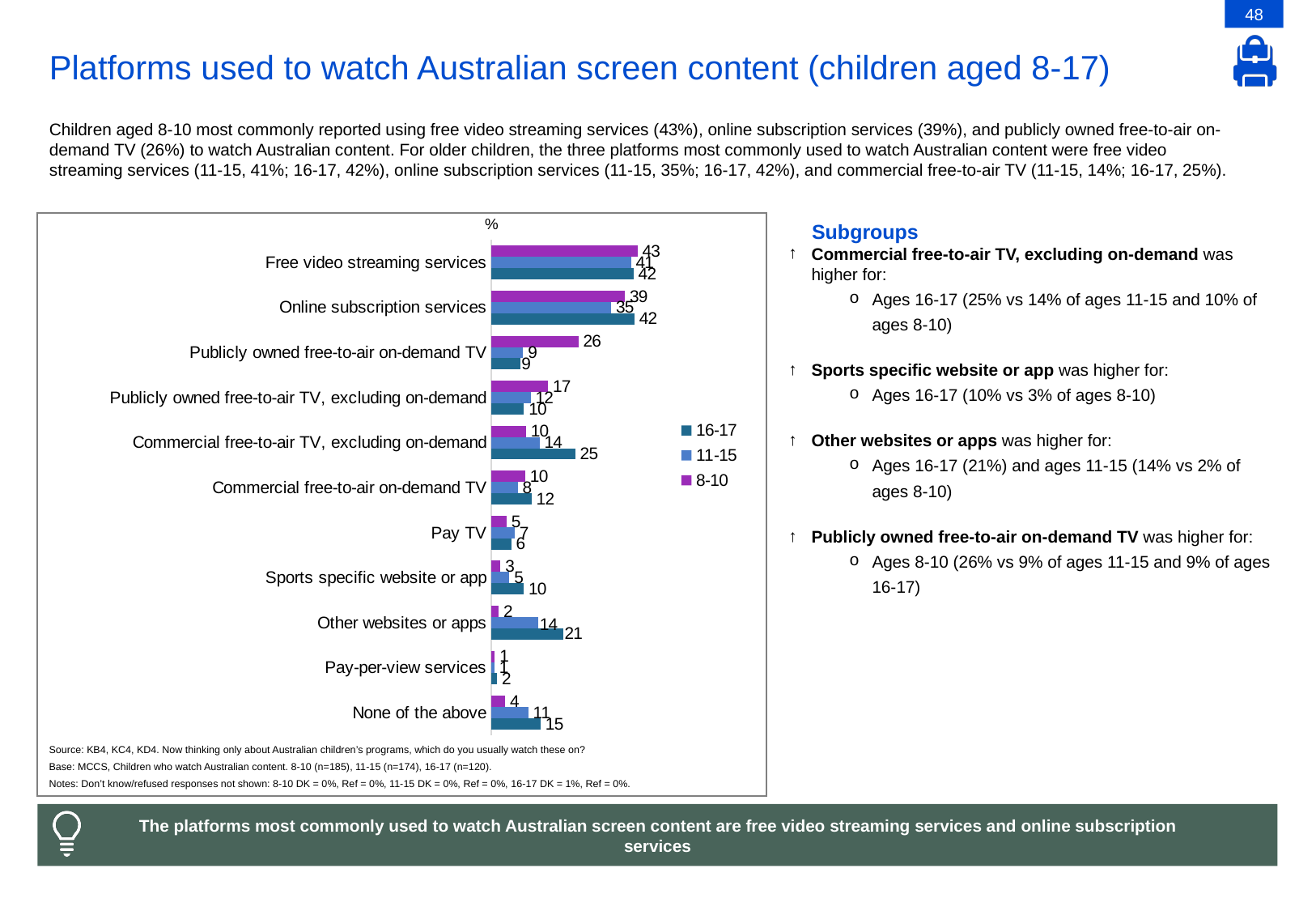
How many series does the chart legend list? 3 How many platform categories are plotted on the chart? 11 What is the value for ages 11-15 for None of the above? 11 Which platform has the lowest value for ages 16-17? Pay-per-view services What is the value for ages 8-10 for Free video streaming services? 43 Which platform has the highest value for ages 8-10? Free video streaming services What is the value for ages 11-15 for Other websites or apps? 14 What is the difference between the 8-10 and 11-15 values for Publicly owned free-to-air on-demand TV? 17 Which legend entry is shown in purple? 8-10 For Sports specific website or app, which age group has the larger value, 8-10 or 16-17? 16-17 What is the value for ages 16-17 for Commercial free-to-air TV, excluding on-demand? 25 What kind of chart is shown on the slide? Bar chart